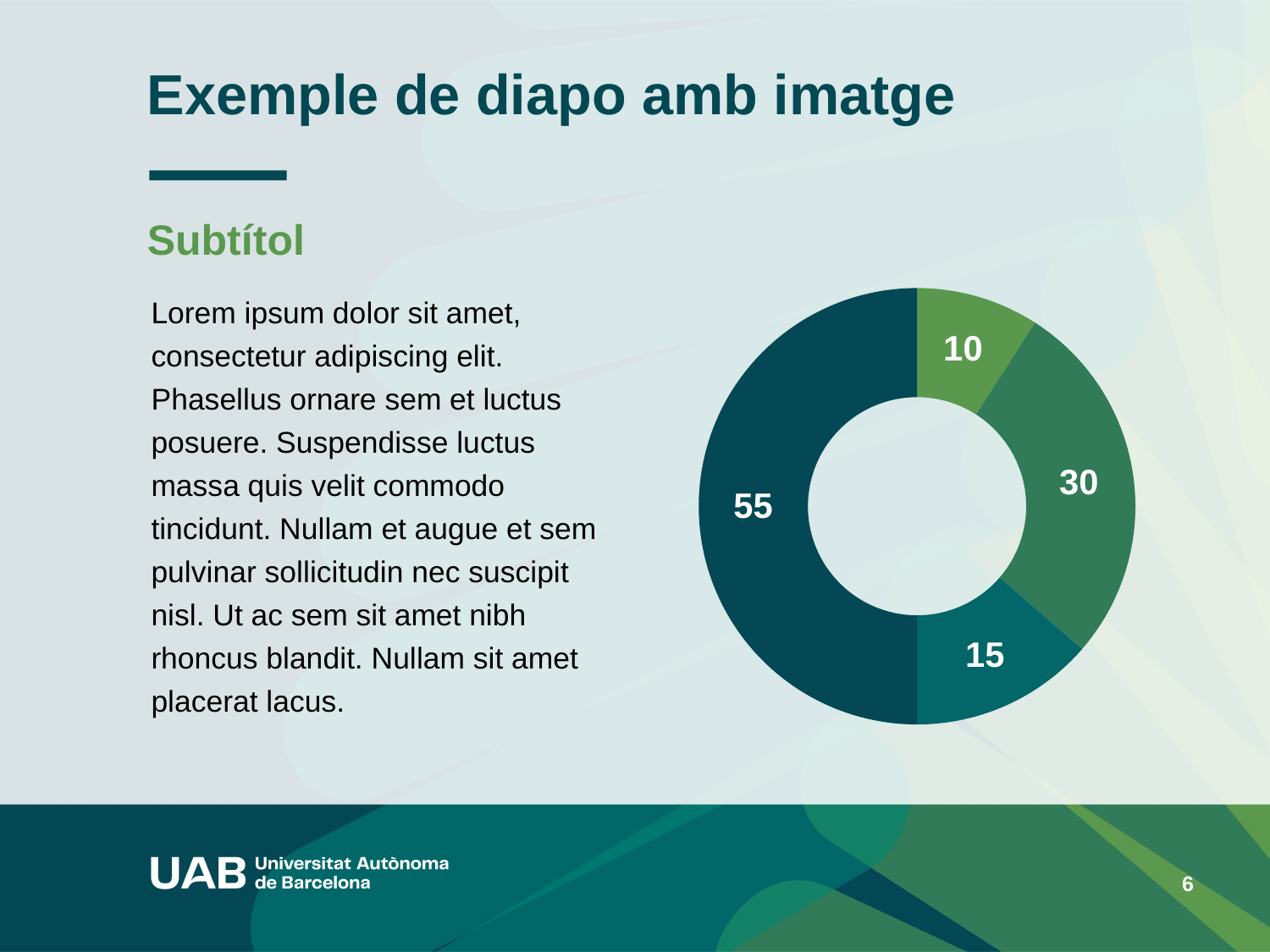
What share of the whole doughnut does the slice labelled 55 represent? 50% What value is shown on the light green slice at the top right of the doughnut chart? 10 What is the difference between the slices labelled 15 and 10? 5 How many slices does the doughnut chart have? 4 Which is larger, the slice labelled 30 or the slice labelled 15? 30 What is the value of the largest slice in the doughnut chart? 55 What kind of chart is shown on the slide? doughnut chart What value is shown on the slice at the bottom right of the doughnut chart? 15 What is the value of the smallest slice in the doughnut chart? 10 What is the difference between the largest slice (55) and the slice labelled 30? 25 What value is shown on the dark teal slice on the left side of the doughnut chart? 55 What is the total of all the slice values in the doughnut chart? 110